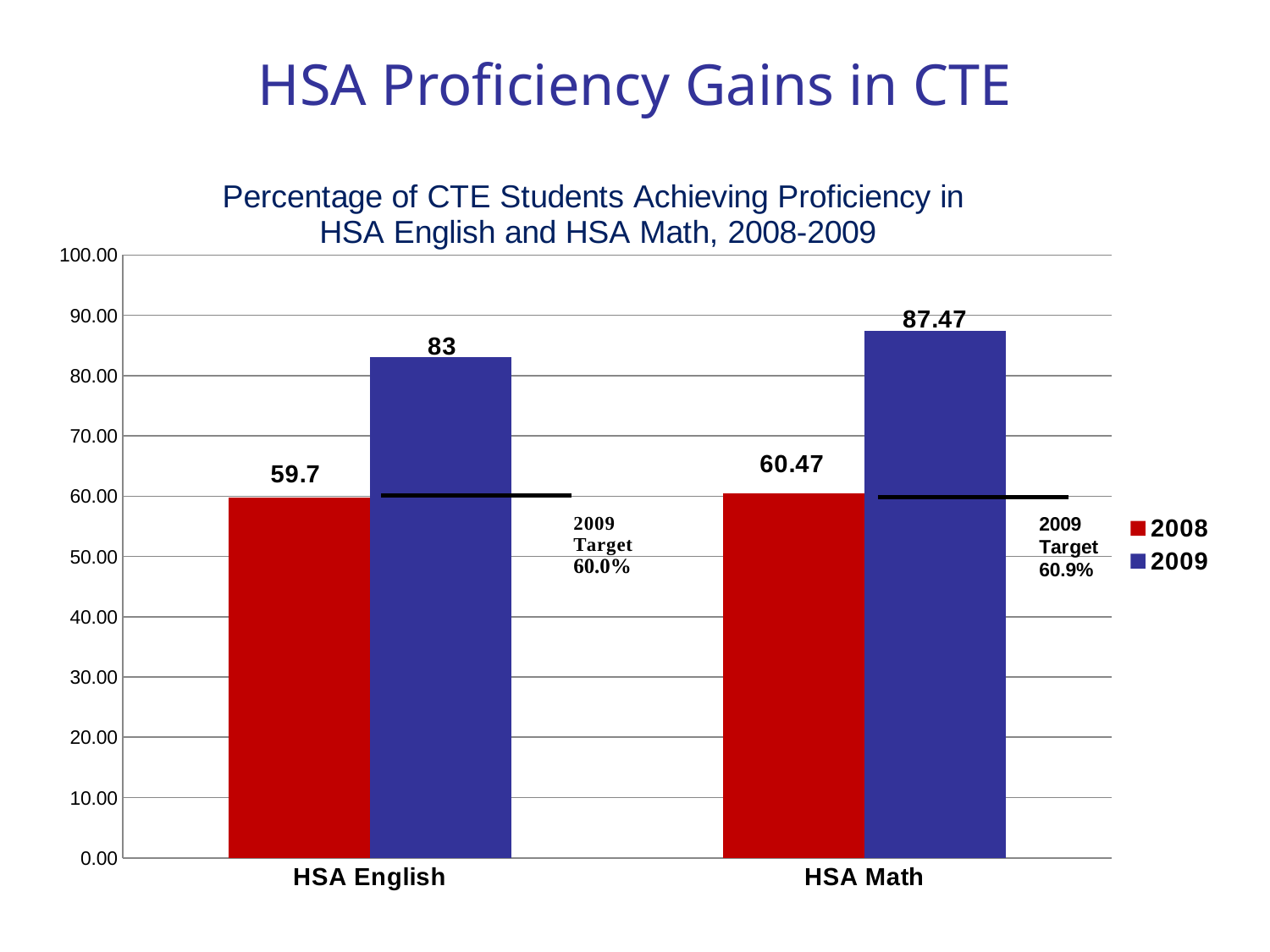
Which category has the highest 2009 value? HSA Math What is the 2009 target shown for HSA Math? 60.9% What kind of chart is shown? Bar chart What is the 2008 value for HSA English? 59.7 What is the difference between the 2009 and 2008 values for HSA English? 23.3 What is the 2009 value for HSA English? 83 What is the 2009 value for HSA Math? 87.47 Which is larger, the 2009 value for HSA English or the 2009 value for HSA Math? HSA Math What is the 2008 value for HSA Math? 60.47 What is the difference between the 2009 and 2008 values for HSA Math? 27 Which bar is the lowest on the chart? 2008 HSA English How many series does the legend list? 2